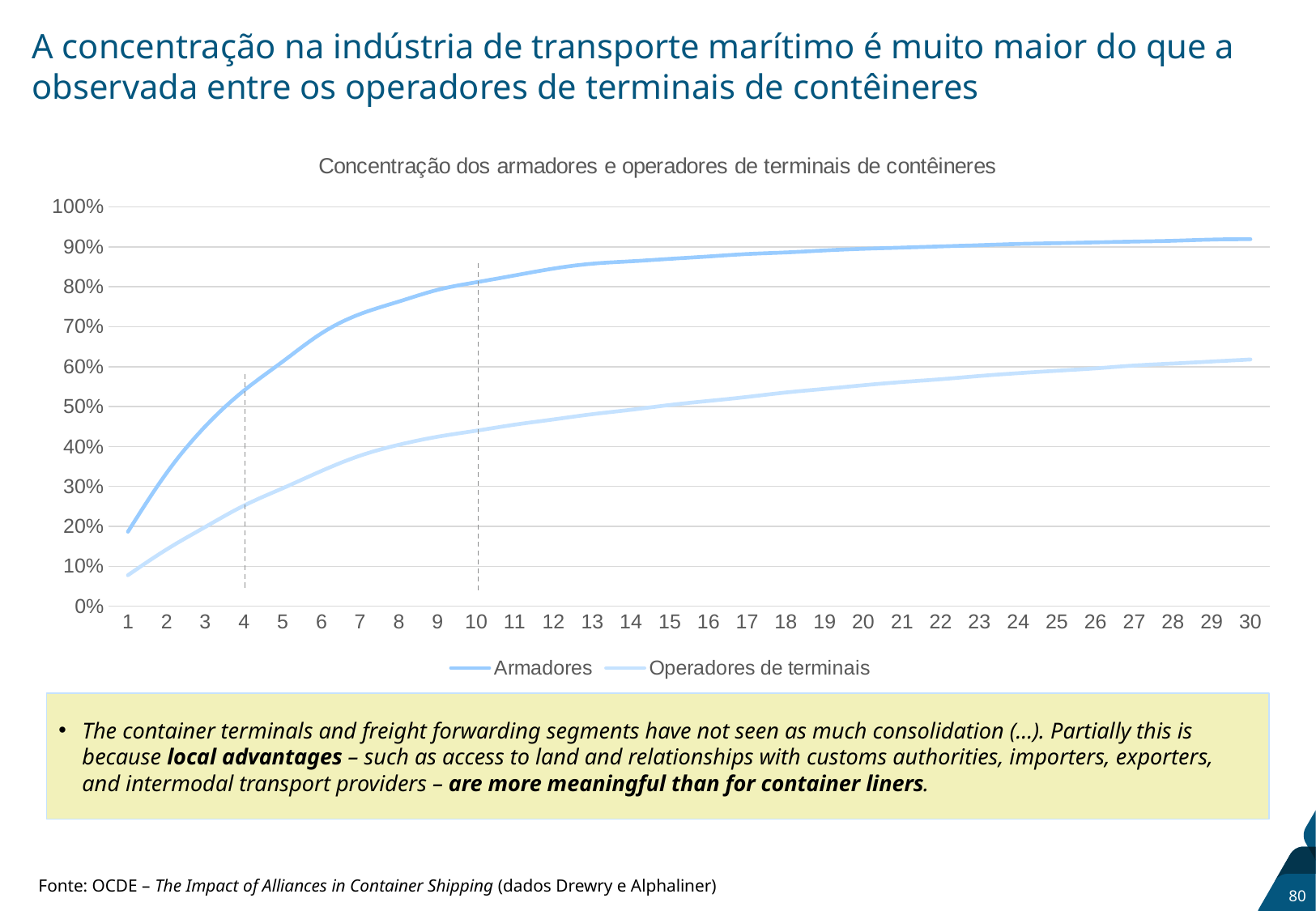
How many points are plotted along the x axis for each series? 30 Is the value for Armadores at x = 30 greater or less than 90%? greater Do the values for Armadores rise or fall as the x axis goes from 1 to 30? Rise Is the value for Armadores at x = 1 greater or less than 20%? less At x = 10, which series has the larger value, Armadores or Operadores de terminais? Armadores What is the title of the chart? Concentração dos armadores e operadores de terminais de contêineres What kind of chart is shown on the slide? Line chart How many series does the legend list? 2 Is the value for Operadores de terminais at x = 30 greater or less than 60%? greater Do the values for Operadores de terminais rise or fall along the x axis? Rise What are the two series named in the legend? Armadores and Operadores de terminais